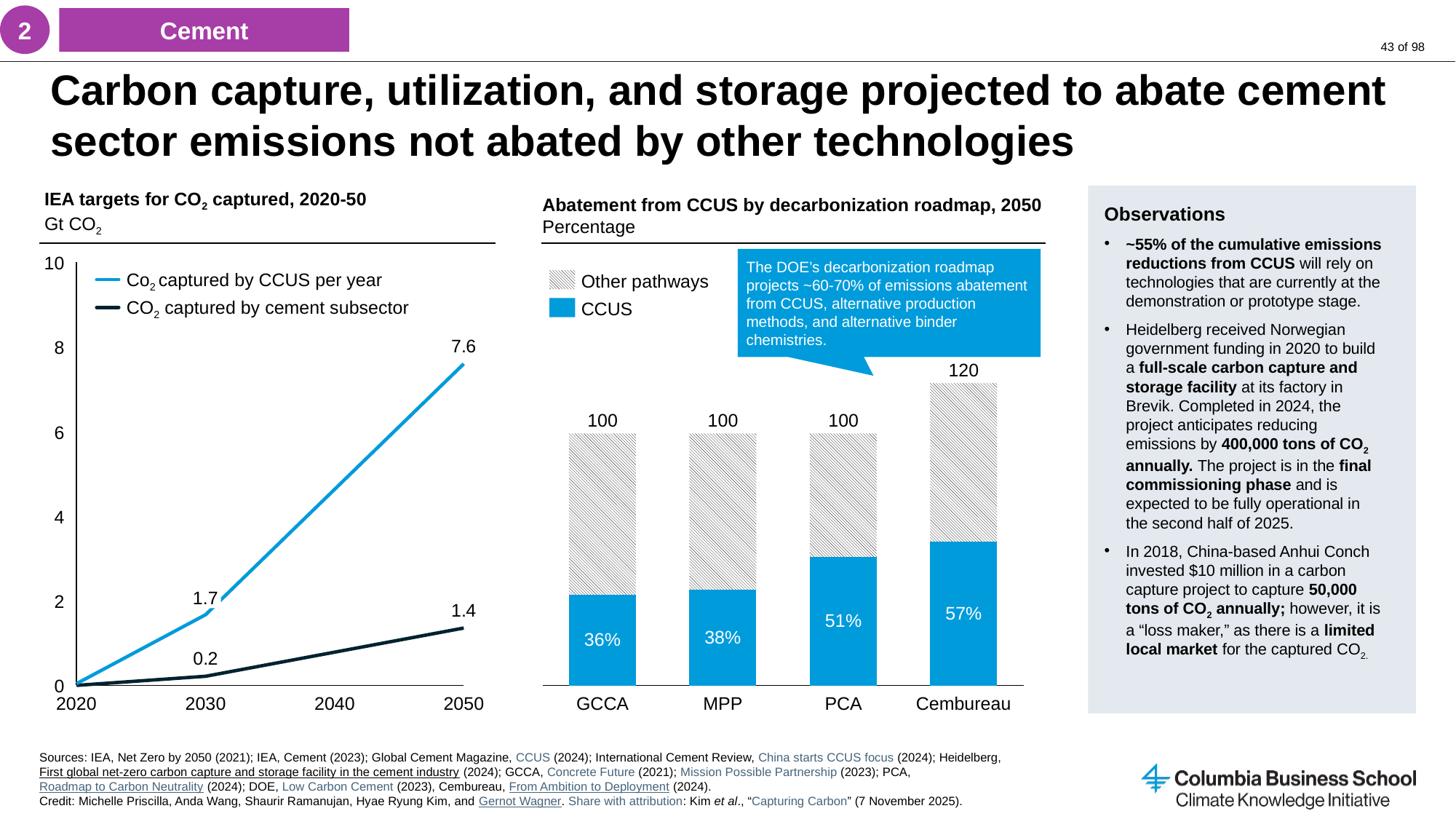
How many series does the legend of the chart 'IEA targets for CO2 captured, 2020-50' list? 2 In the chart 'IEA targets for CO2 captured, 2020-50', what is the value for CO2 captured by CCUS per year in 2030? 1.7 In the chart 'Abatement from CCUS by decarbonization roadmap, 2050', what is the CCUS percentage for PCA? 51% In the chart 'IEA targets for CO2 captured, 2020-50', what is the value for CO2 captured by cement subsector in 2050? 1.4 In the chart 'Abatement from CCUS by decarbonization roadmap, 2050', which roadmap has the highest CCUS percentage? Cembureau How many roadmaps are shown on the x axis of the chart 'Abatement from CCUS by decarbonization roadmap, 2050'? 4 In the chart 'IEA targets for CO2 captured, 2020-50', what is the value for CO2 captured by CCUS per year in 2050? 7.6 In the chart 'Abatement from CCUS by decarbonization roadmap, 2050', which roadmap has the lowest CCUS percentage? GCCA In the chart 'IEA targets for CO2 captured, 2020-50', what is the difference in 2050 between CO2 captured by CCUS per year and CO2 captured by cement subsector? 6.2 In the chart 'Abatement from CCUS by decarbonization roadmap, 2050', what is the total of the Cembureau bar? 120 In the chart 'IEA targets for CO2 captured, 2020-50', does CO2 captured by CCUS per year rise or fall from 2020 to 2050? Rise What kind of chart is 'IEA targets for CO2 captured, 2020-50'? Line chart